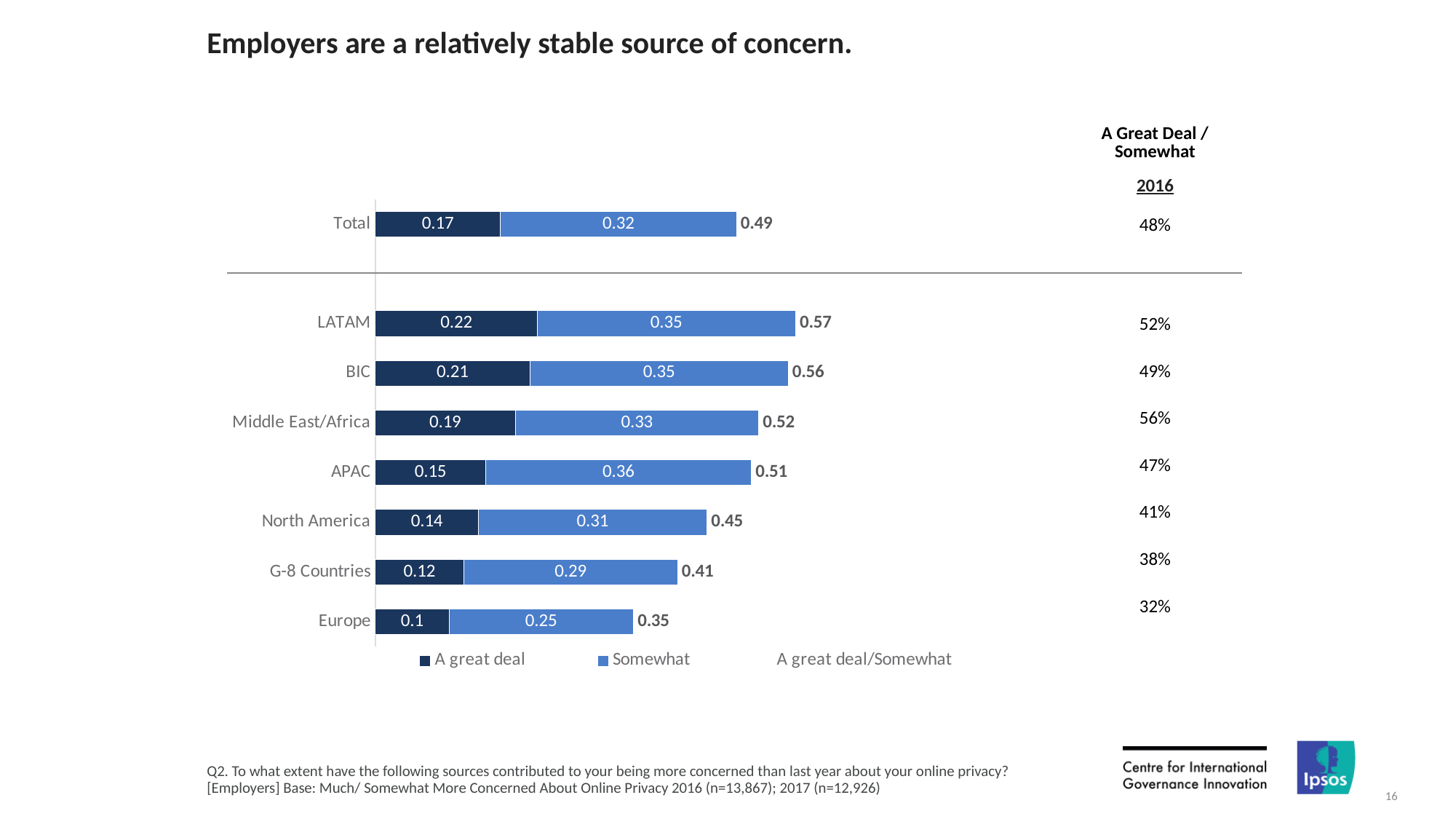
What is the combined "A great deal/Somewhat" value shown for Europe? 0.35 What is the total of the stacked bar for Middle East/Africa? 0.52 Which is larger, the "Somewhat" value for North America or for G-8 Countries? North America What is the "A great deal" value for LATAM? 0.22 Which region has the highest combined "A great deal/Somewhat" value? LATAM What is the "Somewhat" value for APAC? 0.36 How many entries does the legend list? 3 How many regional categories are plotted below the Total bar? 7 Which region has the lowest "A great deal" value? Europe What kind of chart is shown on the slide? Stacked bar chart What 2016 "A Great Deal / Somewhat" percentage is shown for Middle East/Africa? 56% What is the difference between the combined values for LATAM and Europe? 0.22